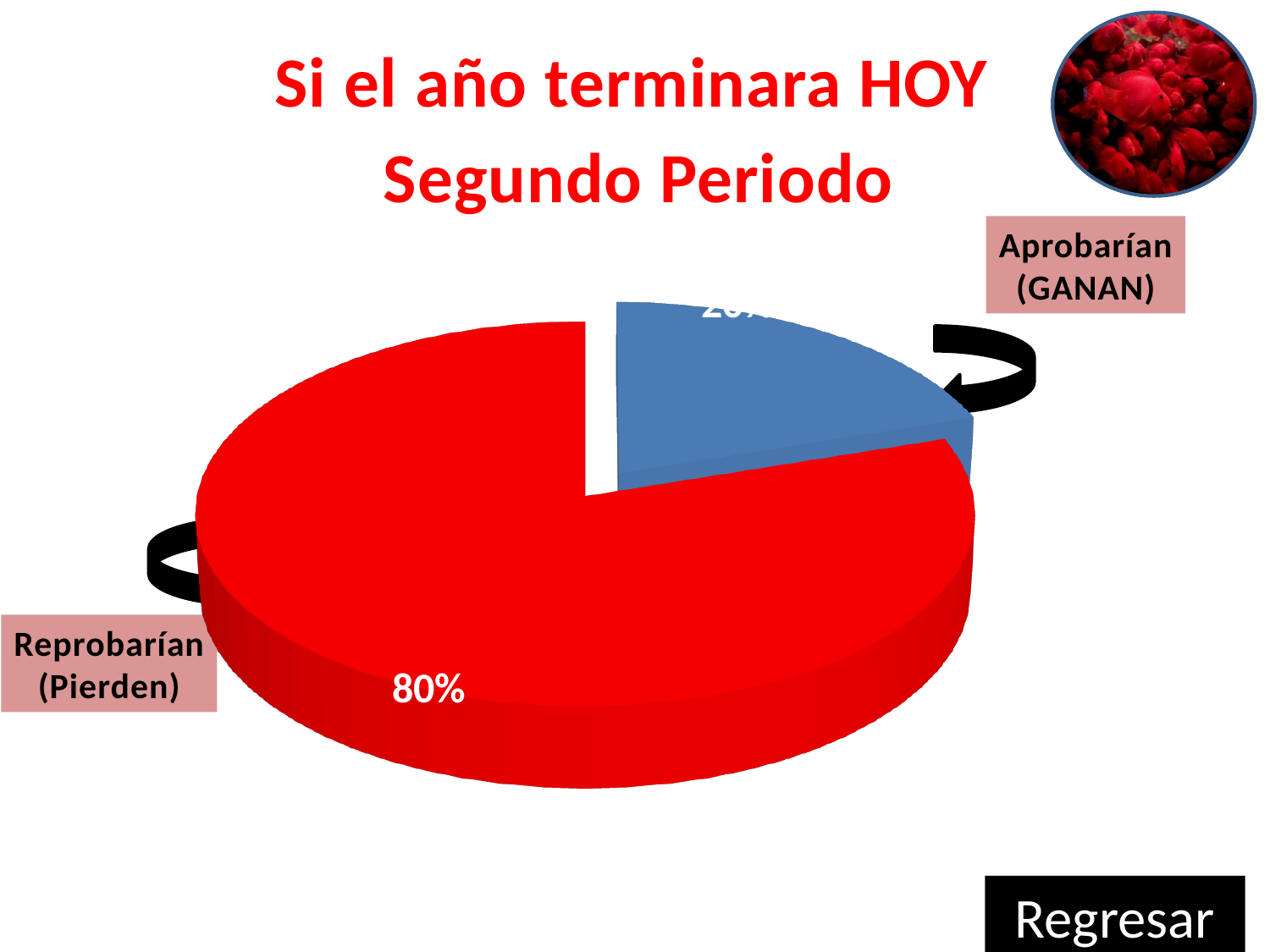
Which is larger, the Reprobarían (Pierden) slice or the Aprobarían (GANAN) slice? Reprobarían (Pierden) What colour is the Reprobarían (Pierden) slice? red What share of the pie does the Reprobarían (Pierden) slice represent? 80% How many slices does the pie chart have? 2 Which slice of the pie chart is the smallest? Aprobarían (GANAN) What is the title shown above the pie chart? Si el año terminara HOY Segundo Periodo What percentage is shown for the Reprobarían (Pierden) slice? 80% Is the share for Reprobarían (Pierden) greater or less than 50%? greater Which slice of the pie chart is the largest? Reprobarían (Pierden) Is the share for Aprobarían (GANAN) greater or less than 50%? less What kind of chart is shown on the slide? pie chart